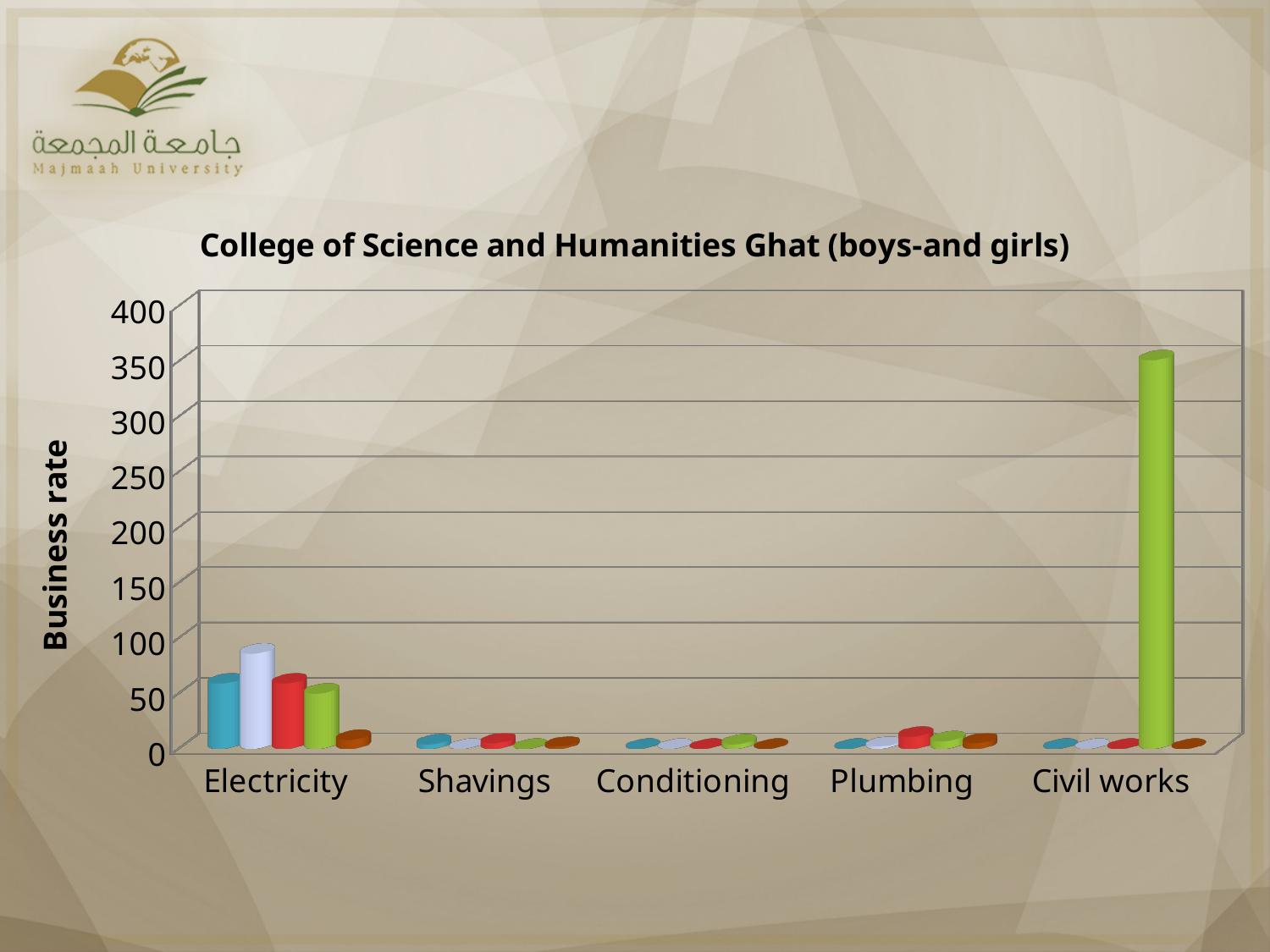
Is the value of the tallest bar for Shavings greater or less than 50? less Is the value of the tallest bar for Civil works greater or less than 300? greater Is the value of the tallest bar for Electricity greater or less than 100? less How many categories are shown along the horizontal axis? 5 What is the label on the vertical axis of the chart? Business rate Which category has the larger tallest bar, Electricity or Plumbing? Electricity What kind of chart is shown on the slide? bar chart Which category has the larger green bar, Civil works or Electricity? Civil works How many bars are plotted for each category? 5 What is the highest value shown on the vertical axis? 400 What is the title of the chart? College of Science and Humanities Ghat (boys-and girls) Which category contains the tallest bar in the chart? Civil works